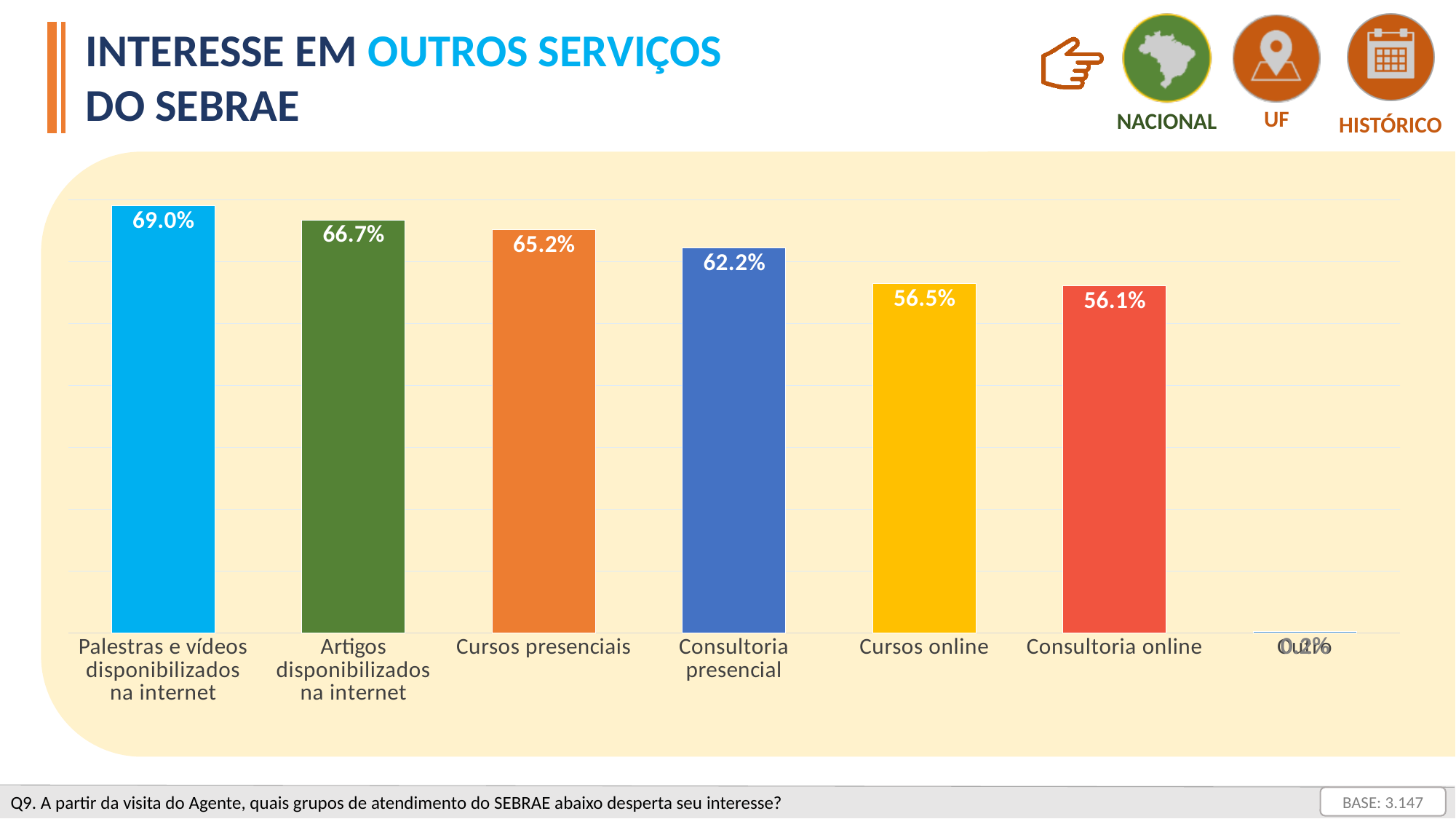
What is the value for Cursos presenciais? 65.2% What is the value for Consultoria online? 56.1% How many categories are shown in the chart? 7 What is the difference between Palestras e vídeos disponibilizados na internet and Artigos disponibilizados na internet? 2.3 percentage points What is the difference between Cursos presenciais and Consultoria presencial? 3.0 percentage points What kind of chart is shown on the slide? Bar chart What is the value for Consultoria presencial? 62.2% Which category has the highest value? Palestras e vídeos disponibilizados na internet What is the value for Artigos disponibilizados na internet? 66.7% What is the value for Cursos online? 56.5% Which is larger, Cursos presenciais or Consultoria presencial? Cursos presenciais What is the value for Palestras e vídeos disponibilizados na internet? 69.0%